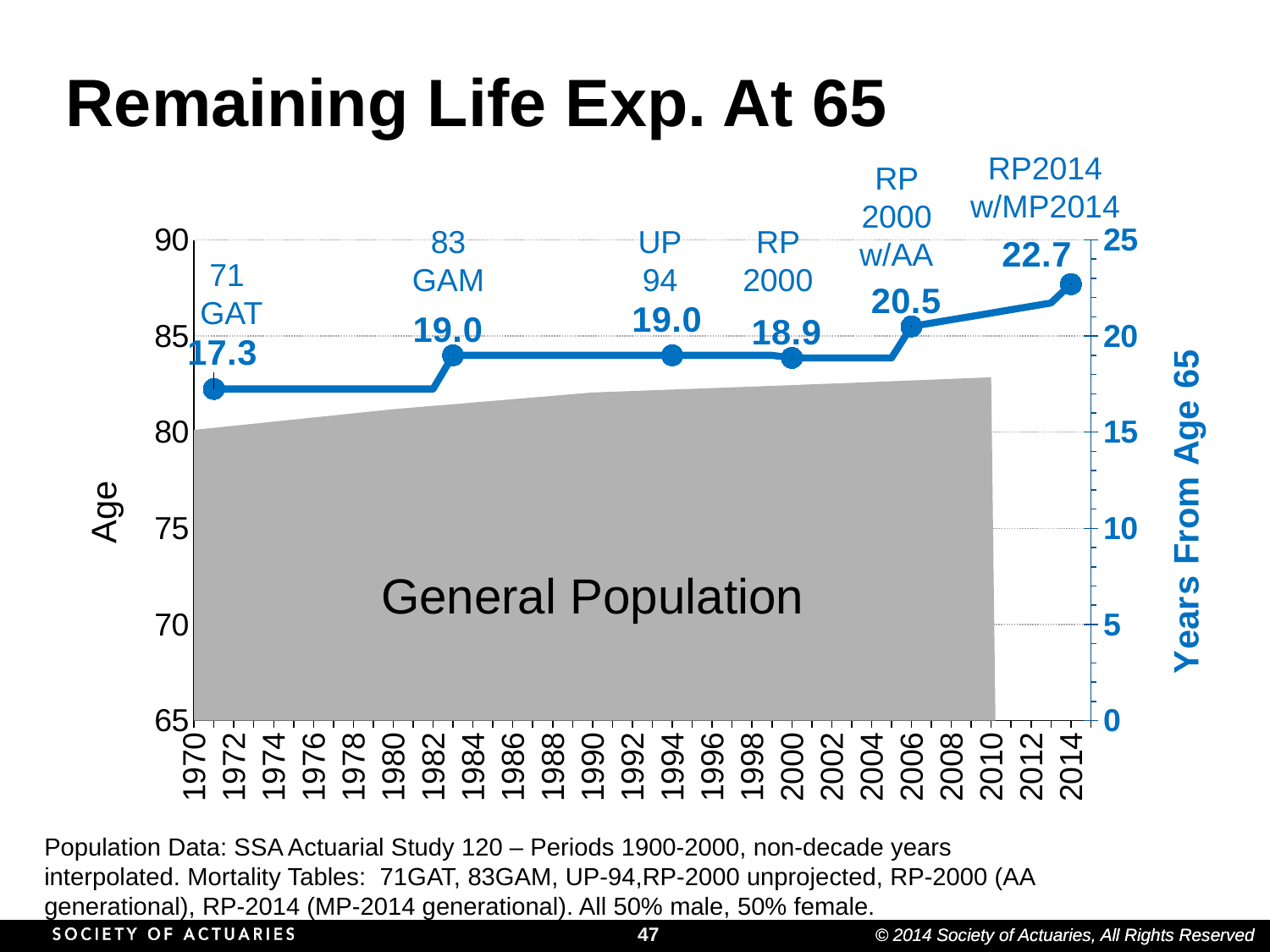
Which is larger, the value for UP 94 or the value for RP 2000? UP 94 What is the value labeled for the RP 2000 w/AA table? 20.5 What is the difference between the RP 2000 w/AA value and the RP 2000 value? 1.6 How many labeled mortality table points are plotted on the line? 6 What is the label of the right-hand vertical axis? Years From Age 65 What is the difference between the RP2014 w/MP2014 value and the 71 GAT value? 5.4 Does the line of mortality table values generally rise or fall from 1970 to 2014? rise Which mortality table has the highest labeled value on the line? RP2014 w/MP2014 Which mortality table has the lowest labeled value on the line? 71 GAT What is the value labeled for the RP2014 w/MP2014 table? 22.7 What is the remaining life expectancy value labeled for the 71 GAT table? 17.3 What is the value labeled for the RP 2000 table? 18.9